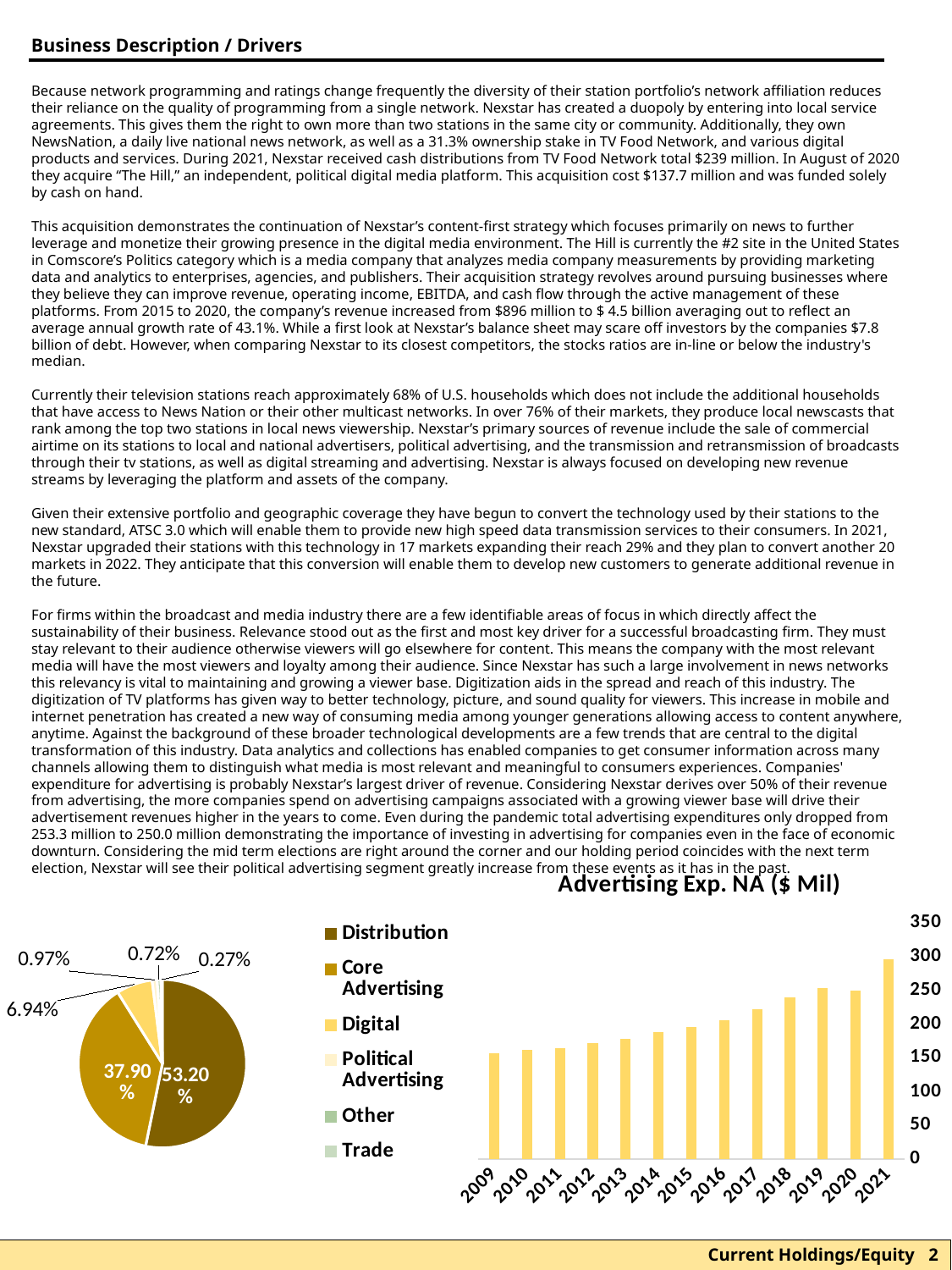
On the pie chart, what share does Distribution have? 53.20% On the 'Advertising Exp. NA ($ Mil)' chart, do the values generally rise or fall from 2009 to 2021? rise On the pie chart, what is the smallest percentage shown? 0.27% On the 'Advertising Exp. NA ($ Mil)' chart, which year has the lowest value? 2009 On the 'Advertising Exp. NA ($ Mil)' chart, which year has the highest value? 2021 On the 'Advertising Exp. NA ($ Mil)' chart, is the value for 2021 greater or less than 250? greater On the pie chart, how many categories does the legend list? 6 On the pie chart, what share does Core Advertising have? 37.90% On the 'Advertising Exp. NA ($ Mil)' chart, is the value for 2009 greater or less than 200? less On the pie chart, what share does Digital have? 6.94% On the pie chart, which category has the largest slice? Distribution On the pie chart, what is the difference in percentage points between Distribution and Core Advertising? 15.30 percentage points